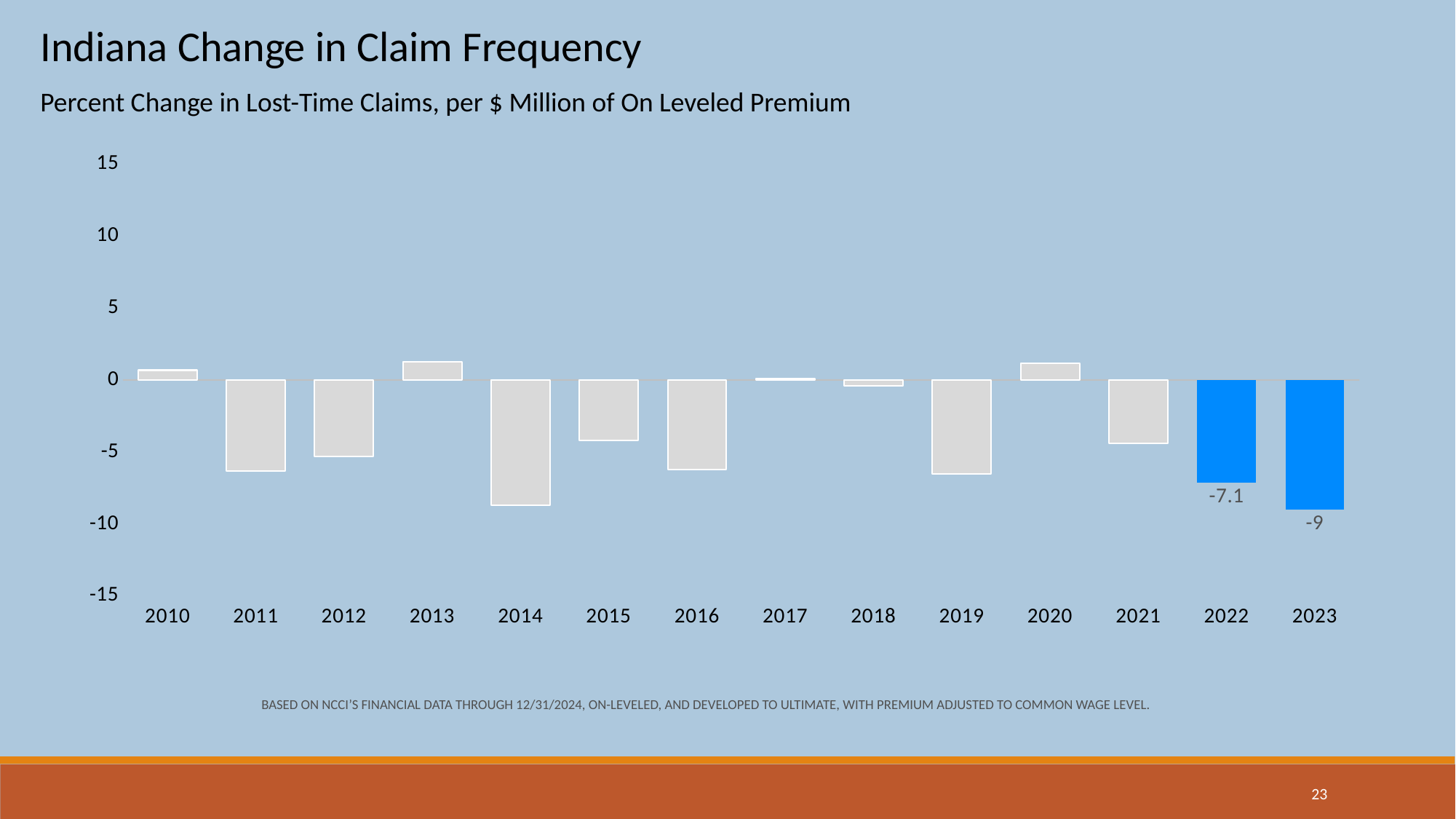
What is the value for 2022? -7.1 Is the value for 2015 greater or less than -5? greater What is the value for 2023? -9 Is the value for 2014 greater or less than -5? less Which years are shown with blue bars? 2022 and 2023 Which year has the larger value, 2010 or 2011? 2010 What is the difference between the values for 2022 and 2023? 1.9 How many years are shown on the x axis? 14 Is the value for 2019 greater or less than -5? less Which year has the larger value, 2022 or 2023? 2022 What kind of chart is shown on the slide? Bar chart